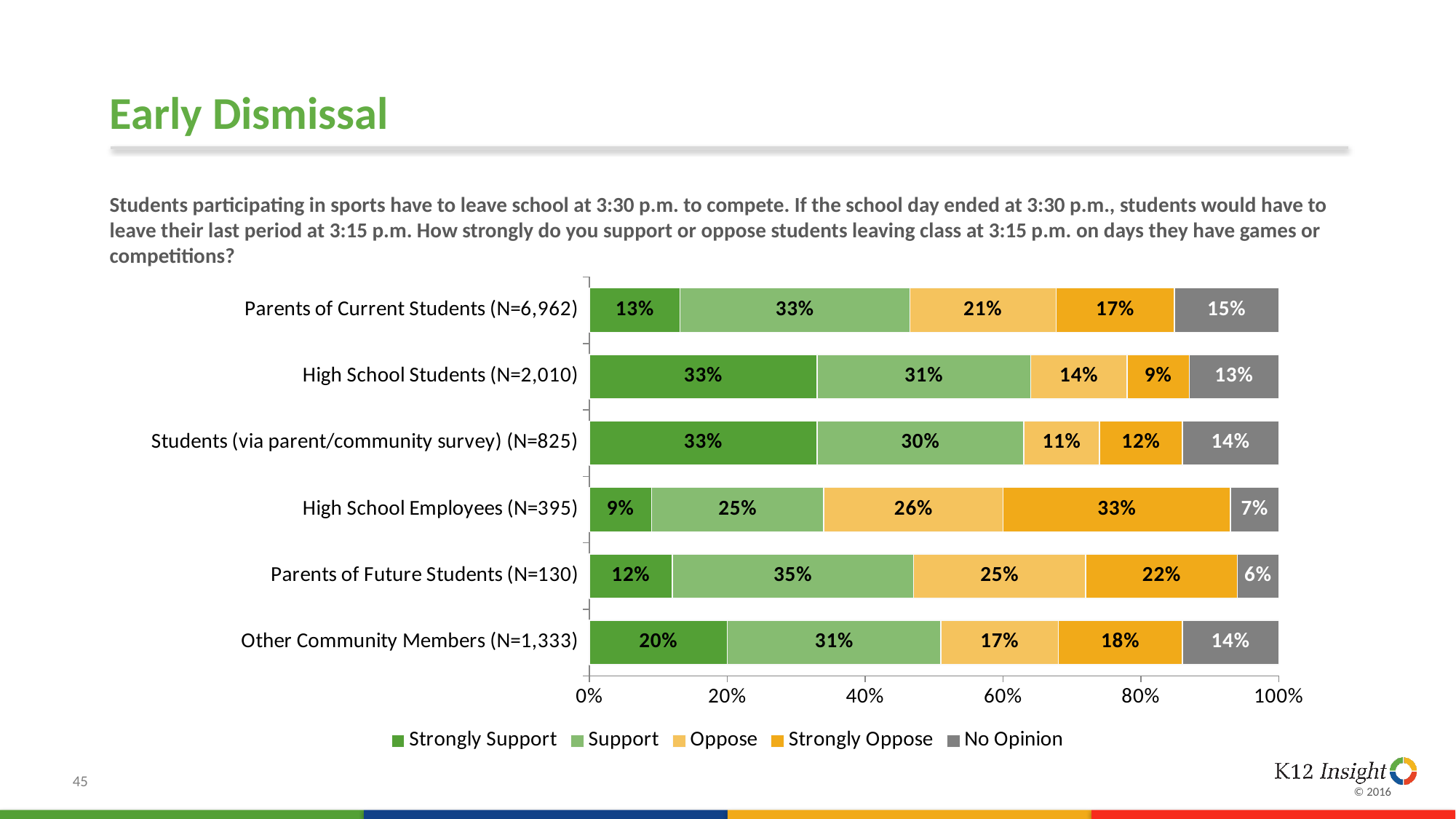
What is the combined Strongly Support and Support percentage for High School Students (N=2,010)? 64% What percentage of Parents of Future Students (N=130) answered No Opinion? 6% Which group has a larger Oppose percentage: Parents of Current Students (N=6,962) or Other Community Members (N=1,333)? Parents of Current Students (N=6,962) Which group has the highest Strongly Oppose percentage? High School Employees (N=395) What percentage of High School Employees (N=395) answered Strongly Oppose? 33% Which group has the lowest Strongly Support percentage? High School Employees (N=395) What percentage of High School Students (N=2,010) answered Strongly Support? 33% How many response categories does the legend list? 5 How many percentage points higher is the Support value for Parents of Future Students (N=130) than for High School Employees (N=395)? 10 percentage points What type of chart is shown on the slide? Stacked bar chart How many respondent groups are shown in the chart? 6 Which group has the highest No Opinion percentage? Parents of Current Students (N=6,962)